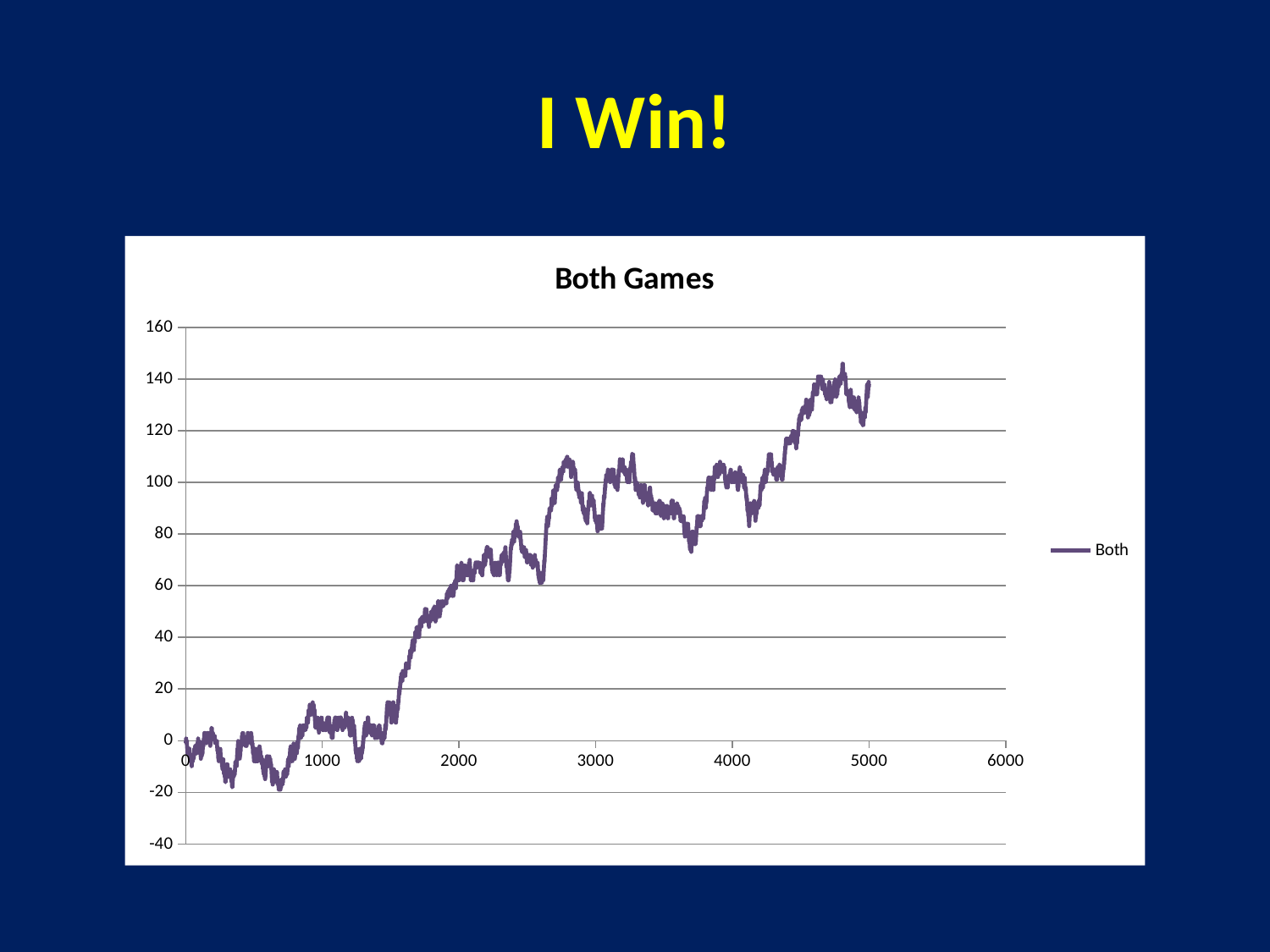
Is the value of the Both series at x = 4000 greater or less than 80? greater Is the value of the Both series at x = 1000 greater or less than 20? less Is the lowest value reached by the Both series greater or less than 0? less What is the title of the chart? Both Games Overall, do the values rise or fall as the x axis increases from 0 to 5000? rise What kind of chart is shown on the slide? line chart What is the name of the series shown in the legend? Both How many series does the legend list? 1